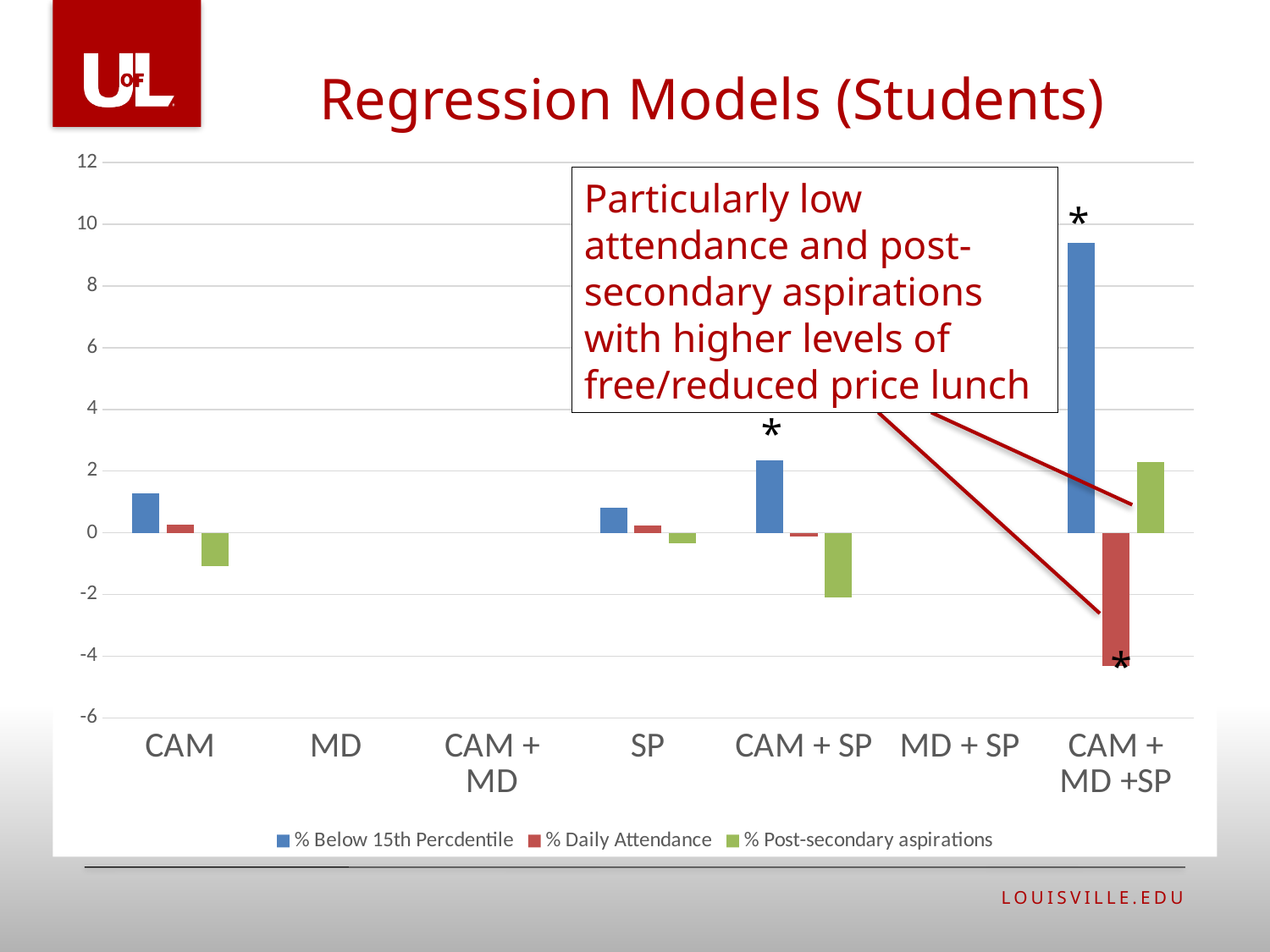
Is the % Daily Attendance value for CAM + MD +SP greater or less than -2? less Is the % Below 15th Percdentile value for CAM + MD +SP greater or less than 8? greater How many series does the legend list? 3 What kind of chart is shown on the slide? bar chart What is the title of the chart? Regression Models (Students) How many categories are shown on the x axis? 7 Which is larger, the % Below 15th Percdentile value for CAM + SP or for SP? CAM + SP Is the % Post-secondary aspirations value for CAM + SP greater or less than 0? less Which series is shown in green? % Post-secondary aspirations Which category has the highest value for % Below 15th Percdentile? CAM + MD +SP Which category has the lowest value for % Daily Attendance? CAM + MD +SP